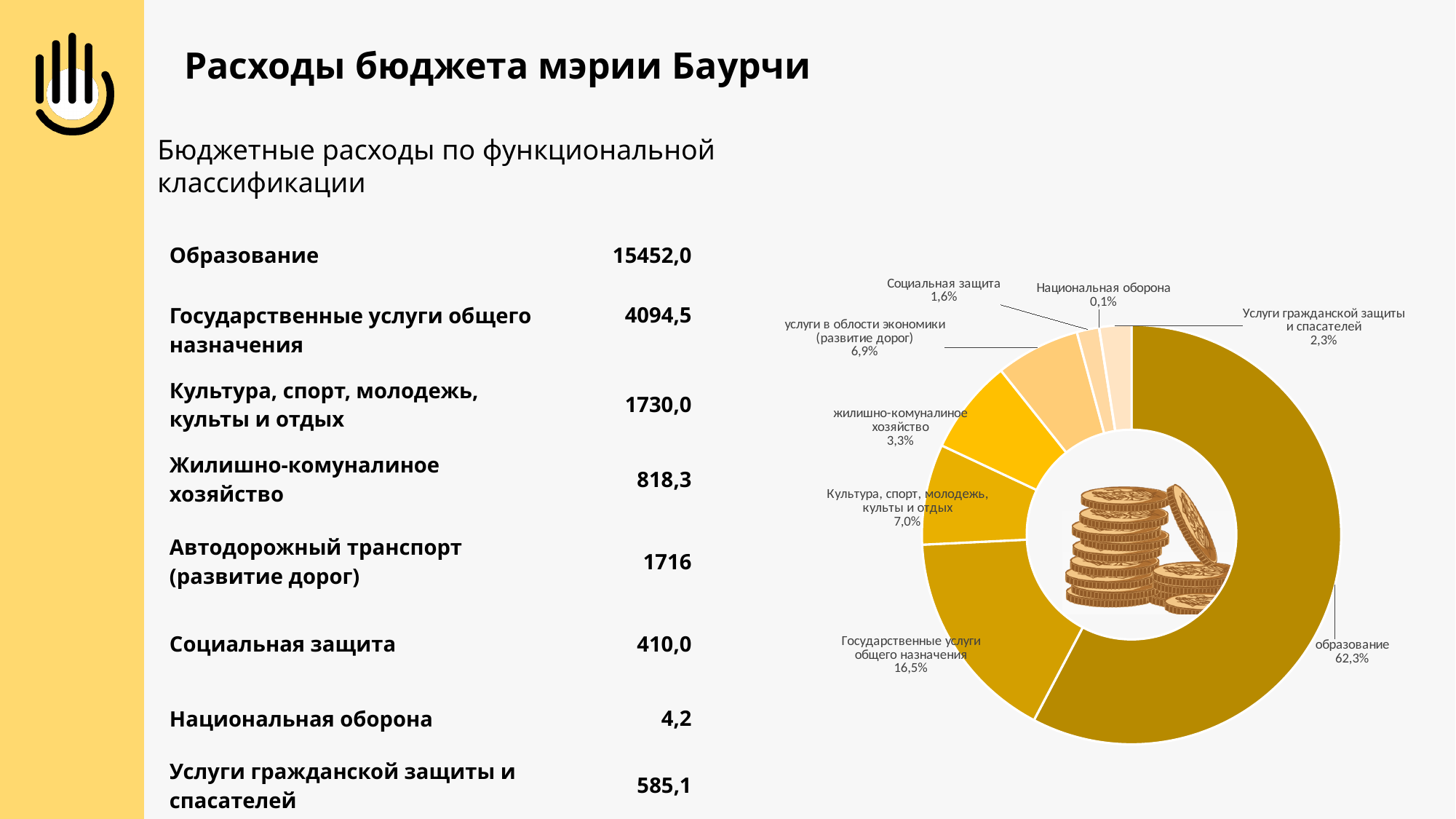
What percentage is shown for Национальная оборона in the chart? 0,1% What share of the doughnut chart does образование take? 62,3% Which category has the largest slice in the chart? образование Which slice is larger in the chart: Социальная защита or Услуги гражданской защиты и спасателей? Услуги гражданской защиты и спасателей How many slices does the doughnut chart have? 8 What is the difference in percentage points between Культура, спорт, молодежь, культы и отдых and жилишно-комуналиное хозяйство in the chart? 3,7% What is the difference in percentage points between образование and Государственные услуги общего назначения in the chart? 45,8% Which category has the smallest slice in the chart? Национальная оборона What is the title of the slide containing the chart? Расходы бюджета мэрии Баурчи What kind of chart is shown on the slide? Doughnut (pie) chart What percentage is shown for услуги в области экономики (развитие дорог) in the chart? 6,9% What percentage is shown for Государственные услуги общего назначения in the chart? 16,5%